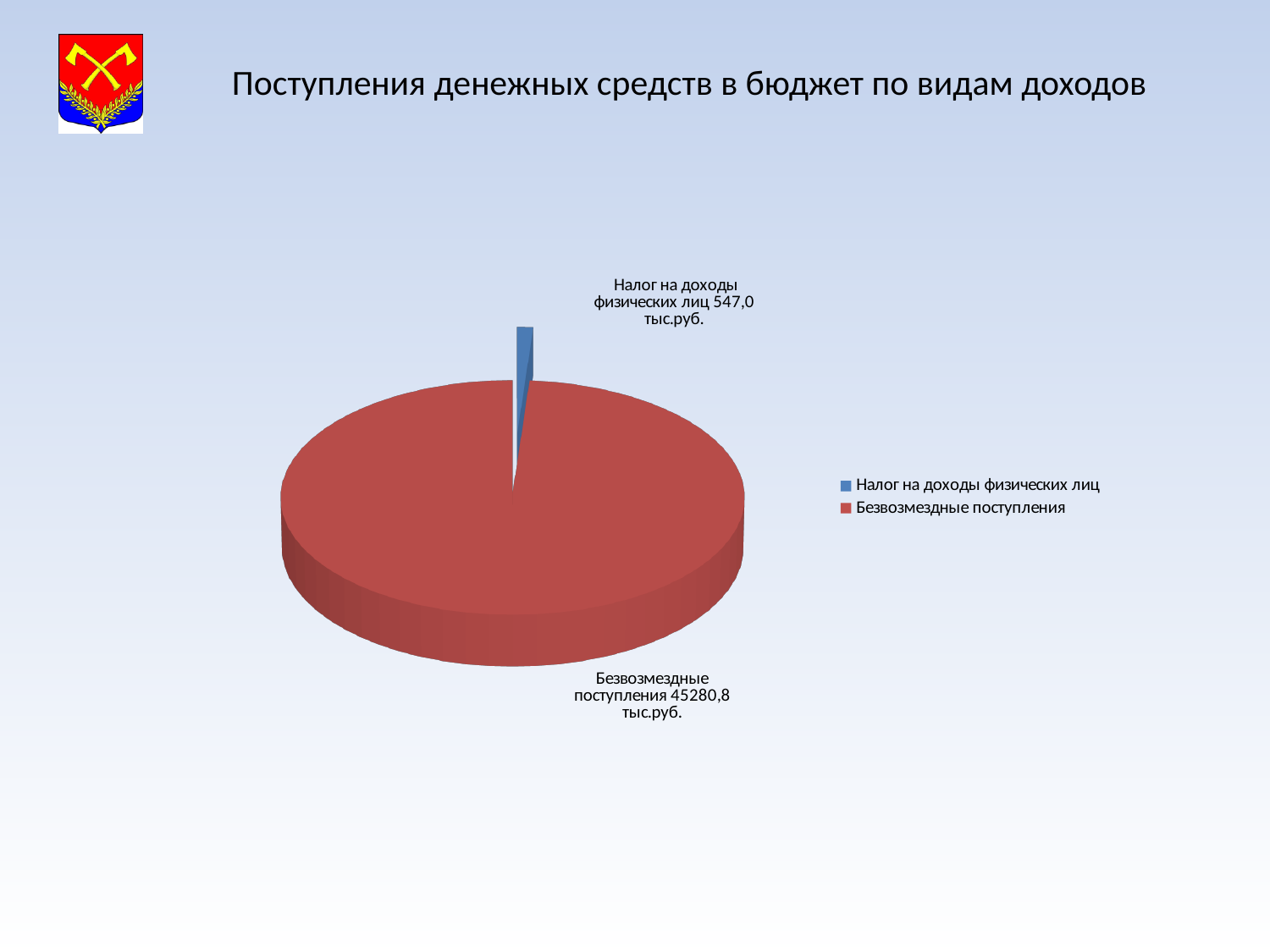
How many entries does the legend list? 2 What is the difference between Безвозмездные поступления and Налог на доходы физических лиц? 44733,8 тыс.руб. What is the total of the two slices in the pie? 45827,8 тыс.руб. What colour is the slice for Безвозмездные поступления? red What is the title of the slide? Поступления денежных средств в бюджет по видам доходов Which category has the largest slice of the pie? Безвозмездные поступления How many slices does the pie chart have? 2 Which is larger: Налог на доходы физических лиц or Безвозмездные поступления? Безвозмездные поступления What is the value for Налог на доходы физических лиц? 547,0 тыс.руб. What kind of chart is shown on the slide? pie chart What is the value for Безвозмездные поступления? 45280,8 тыс.руб. Which category has the smallest slice of the pie? Налог на доходы физических лиц